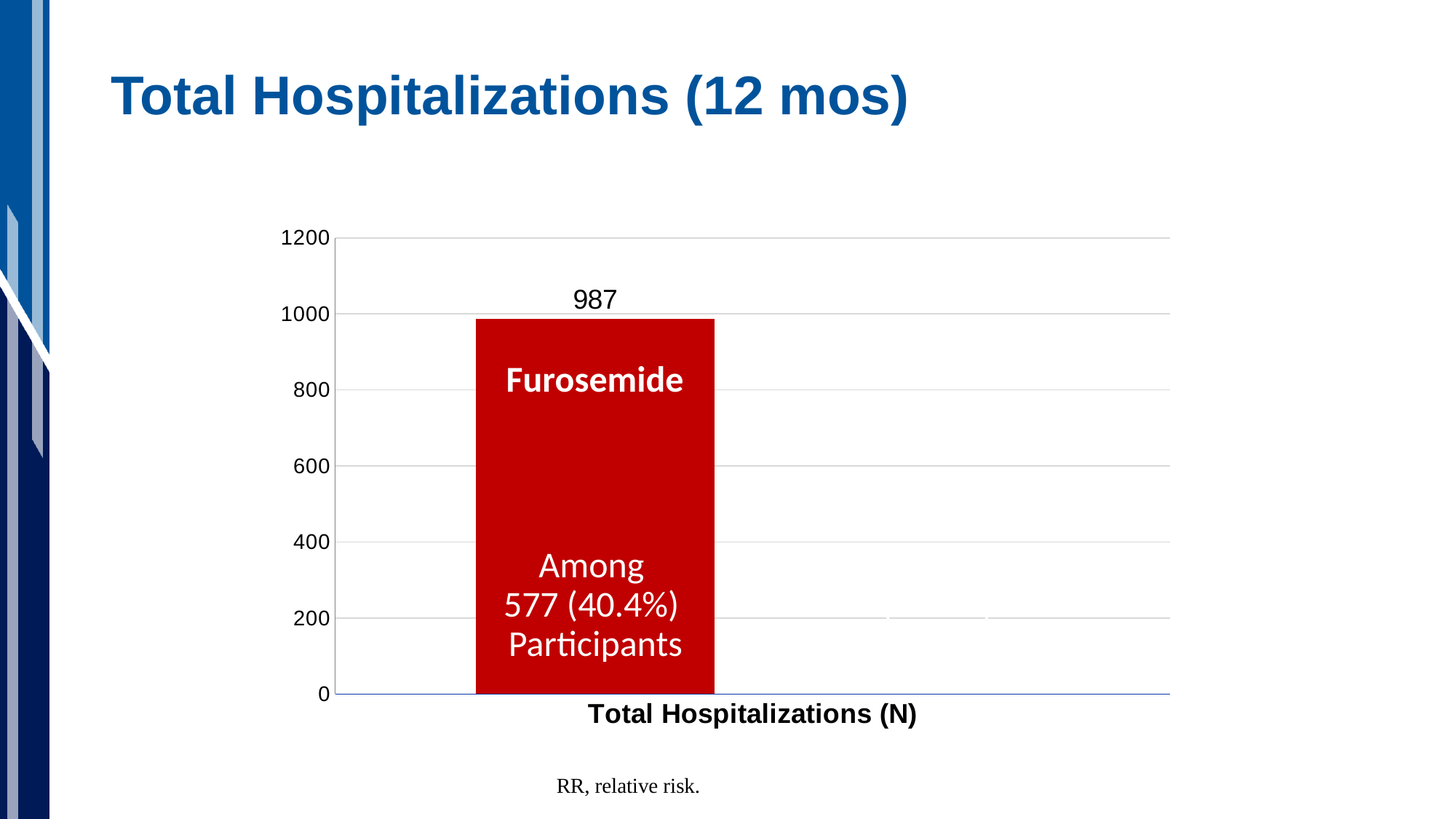
What is the value of the Furosemide bar? 987 What is the highest tick value shown on the vertical axis? 1200 Is the value for Furosemide greater or less than 800? greater Is the value for Furosemide greater or less than 1000? less Among how many participants were the Furosemide hospitalizations counted, according to the text inside the bar? 577 (40.4%) What is the title of the slide containing the chart? Total Hospitalizations (12 mos) How many bars are plotted in the chart? 1 Is the value for Furosemide greater or less than 600? greater What kind of chart is shown on the slide? bar chart What label appears on the horizontal axis of the chart? Total Hospitalizations (N)